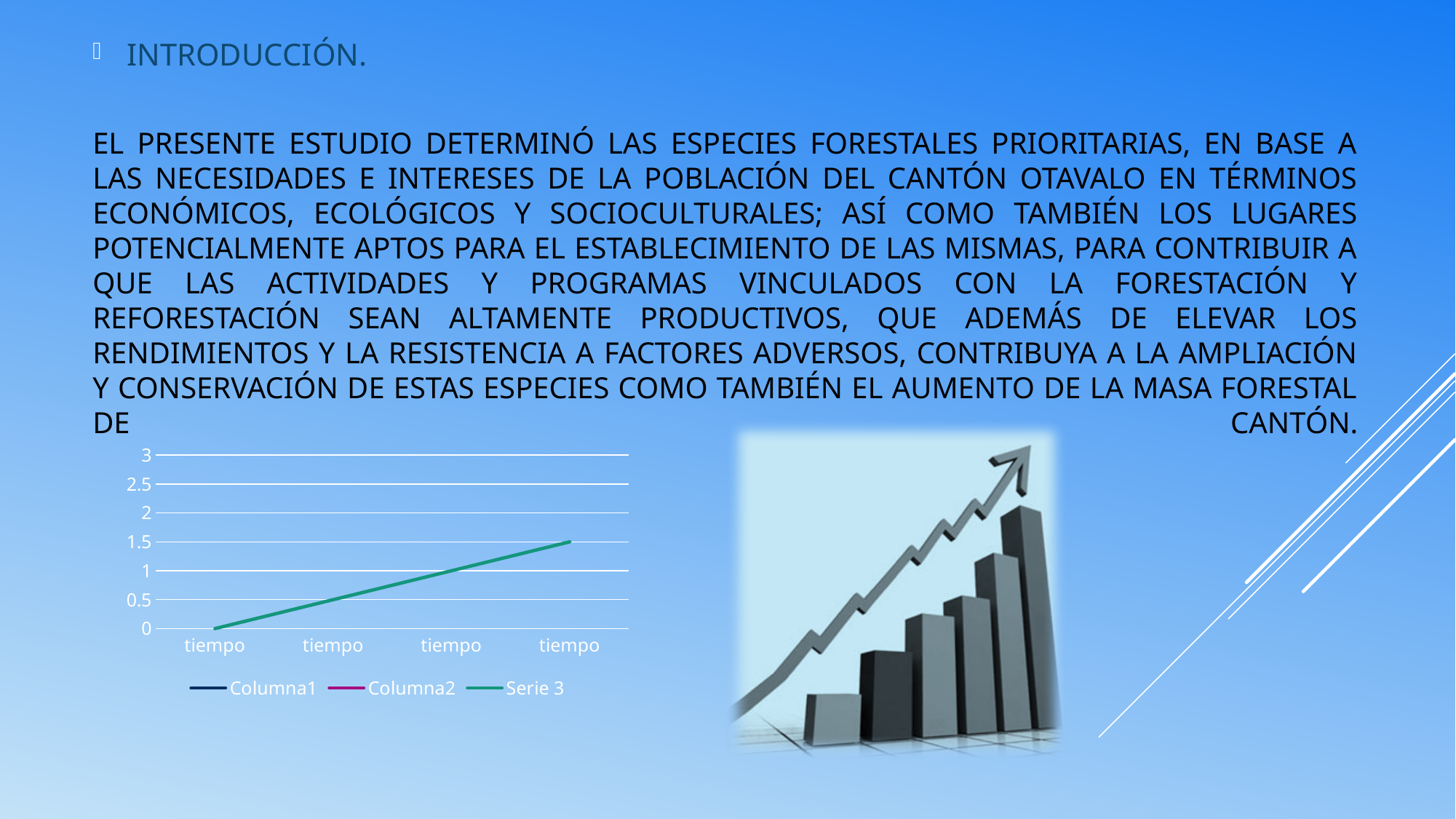
What are the three entries listed in the chart's legend? Columna1, Columna2, Serie 3 How many series does the chart's legend list? 3 Is the Serie 3 value at the second "tiempo" category greater or less than 1? less Which is larger for Serie 3: the value at the first "tiempo" or at the last "tiempo"? the last "tiempo" What is the difference between the Serie 3 value at the last "tiempo" and at the first "tiempo"? 1.5 Does the Serie 3 line rise or fall from left to right along the x axis? rises At which x-axis position does Serie 3 reach its highest value? the last (fourth) "tiempo" Is the Serie 3 value at the third "tiempo" category greater or less than 0.5? greater What is the value of Serie 3 at the last "tiempo" category? 1.5 What kind of chart is shown on the slide? line chart What is the value of Serie 3 at the first "tiempo" category? 0 How many categories are shown along the x axis of the chart? 4